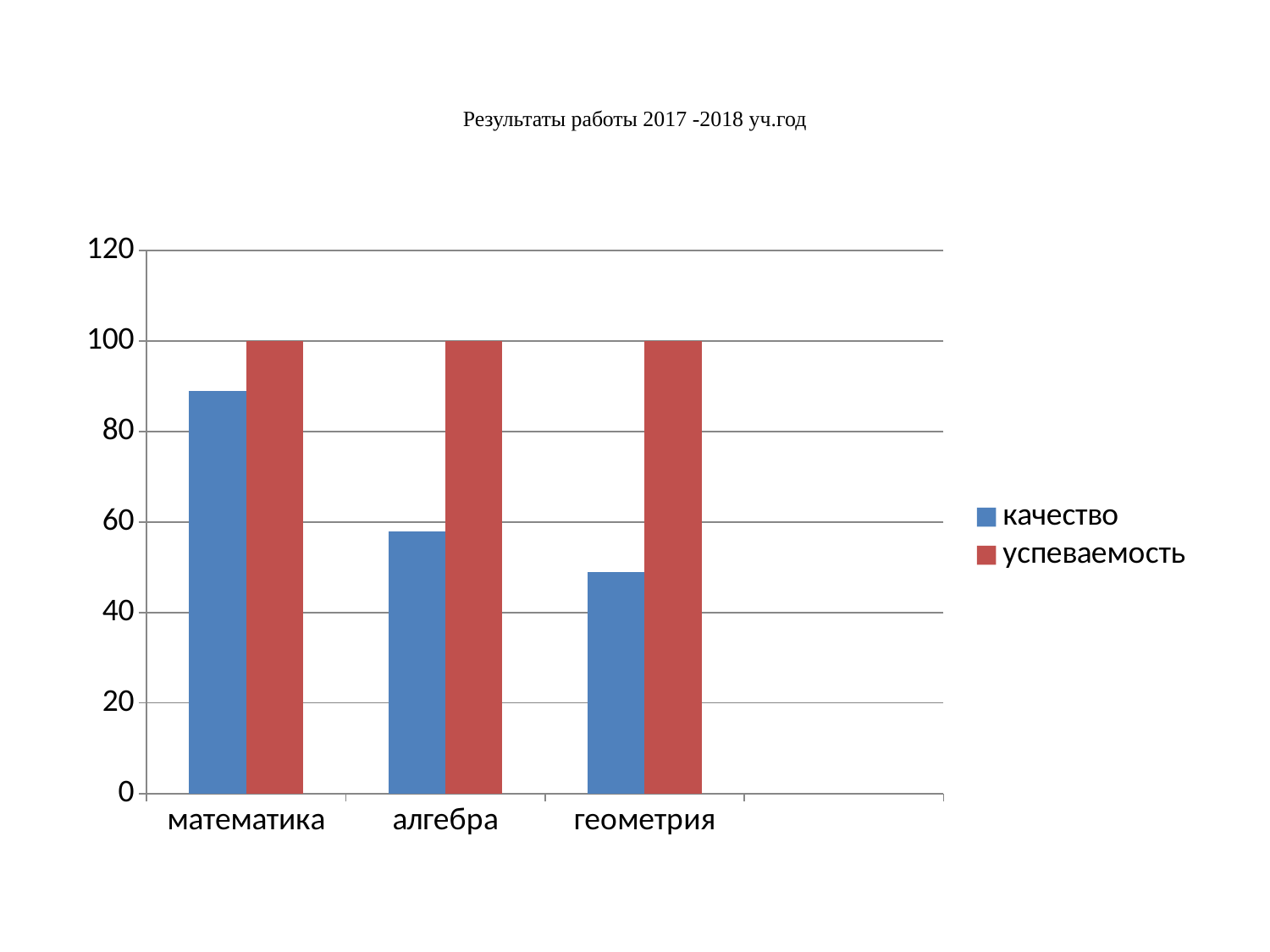
Which category has the lowest value for качество? геометрия Is the value of качество for математика greater or less than 80? greater Is the value of качество for геометрия greater or less than 60? less Which series is shown in red? успеваемость What kind of chart is shown on the slide? bar chart How many categories are shown on the x axis of the chart? 3 What is the value of успеваемость for геометрия? 100 What is the title of the chart? Результаты работы 2017 -2018 уч.год Which category has the highest value for качество? математика What is the value of успеваемость for математика? 100 How many series does the legend list? 2 Does the value of качество rise or fall from математика to геометрия? fall